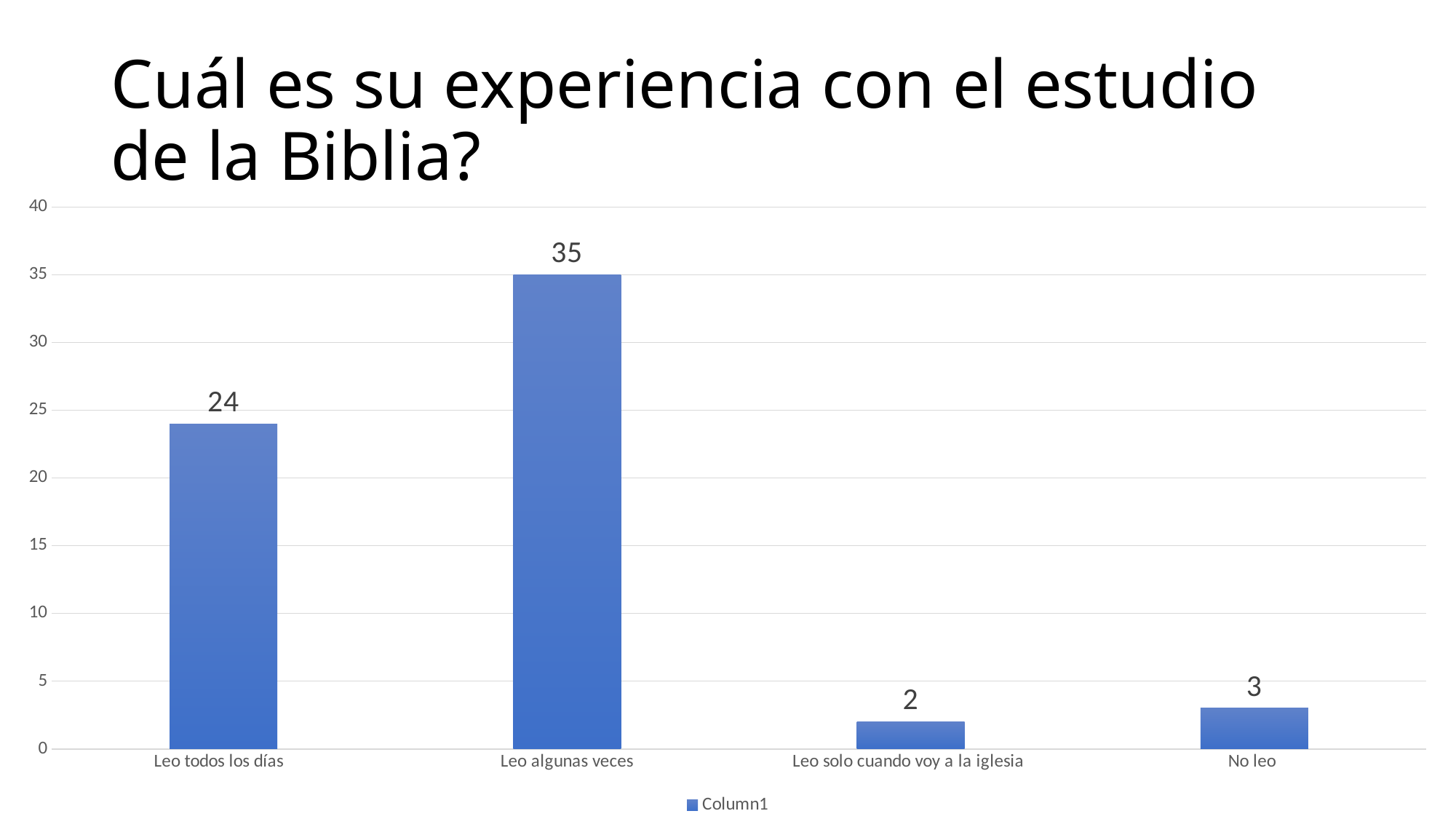
Is the value for "Leo todos los días" greater or less than 20? greater What is the difference between the values for "Leo algunas veces" and "Leo todos los días"? 11 What is the value for "Leo solo cuando voy a la iglesia"? 2 What is the value for "Leo algunas veces"? 35 What kind of chart is shown on the slide? bar chart How many categories are shown on the x axis? 4 What is the name of the series listed in the legend? Column1 Which category has the lowest value? Leo solo cuando voy a la iglesia What is the value for "No leo"? 3 Which category has the highest value? Leo algunas veces What is the value for "Leo todos los días"? 24 Which is larger, the value for "No leo" or the value for "Leo solo cuando voy a la iglesia"? No leo